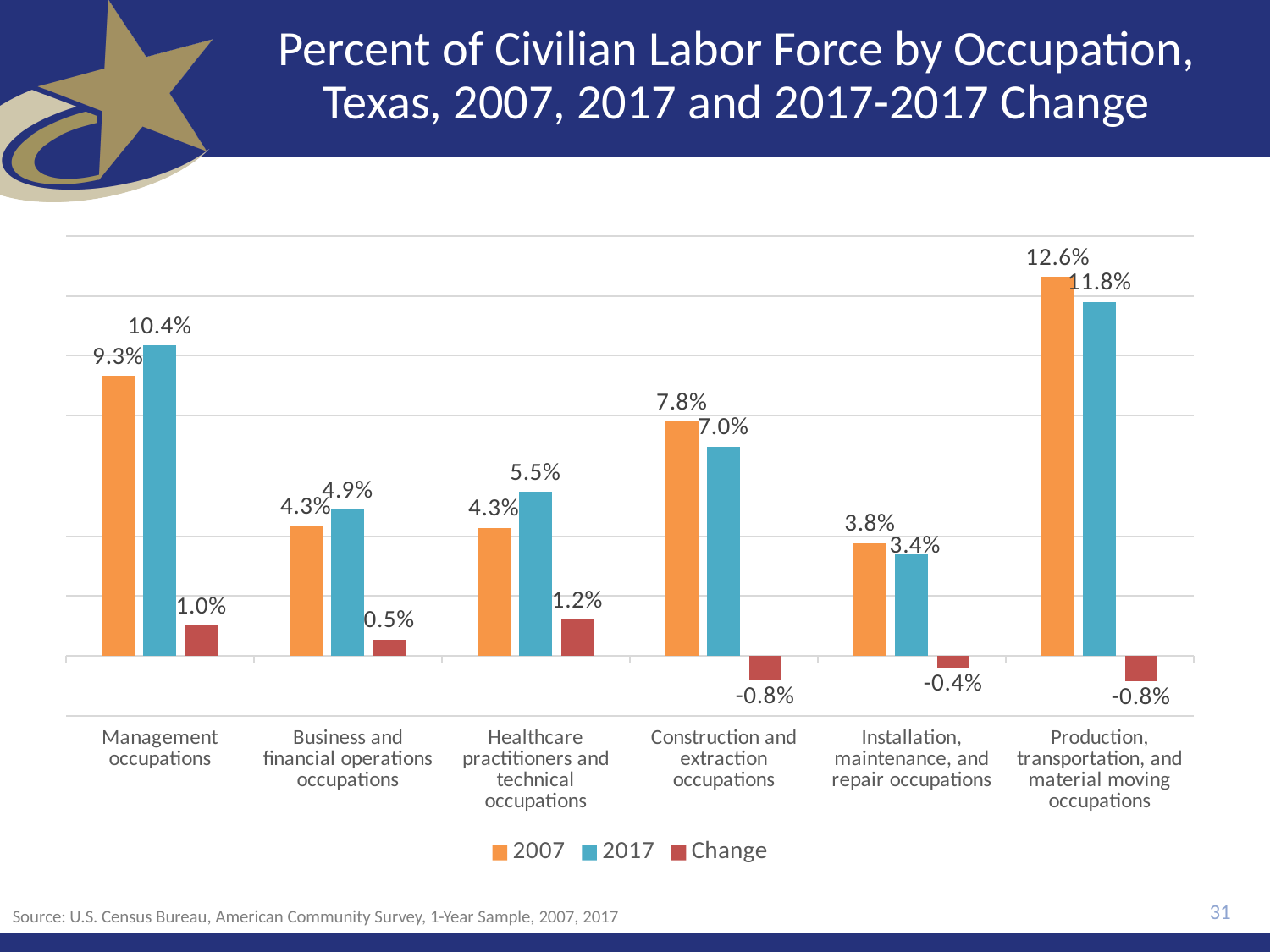
Which occupation has the lowest 2007 value? Installation, maintenance, and repair occupations What kind of chart is shown on the slide? Bar chart What colour represents the 2017 series in the chart? Blue What is the difference between the 2007 and 2017 values for Construction and extraction occupations? 0.8% What was the 2007 value for Management occupations? 9.3% What is the Change value for Healthcare practitioners and technical occupations? 1.2% What is the Change value for Installation, maintenance, and repair occupations? -0.4% How many series does the legend list? 3 Which is larger for Business and financial operations occupations, the 2007 value or the 2017 value? 2017 Which occupation has the highest 2017 value? Production, transportation, and material moving occupations How many occupation categories are shown on the chart? 6 What was the 2017 value for Production, transportation, and material moving occupations? 11.8%